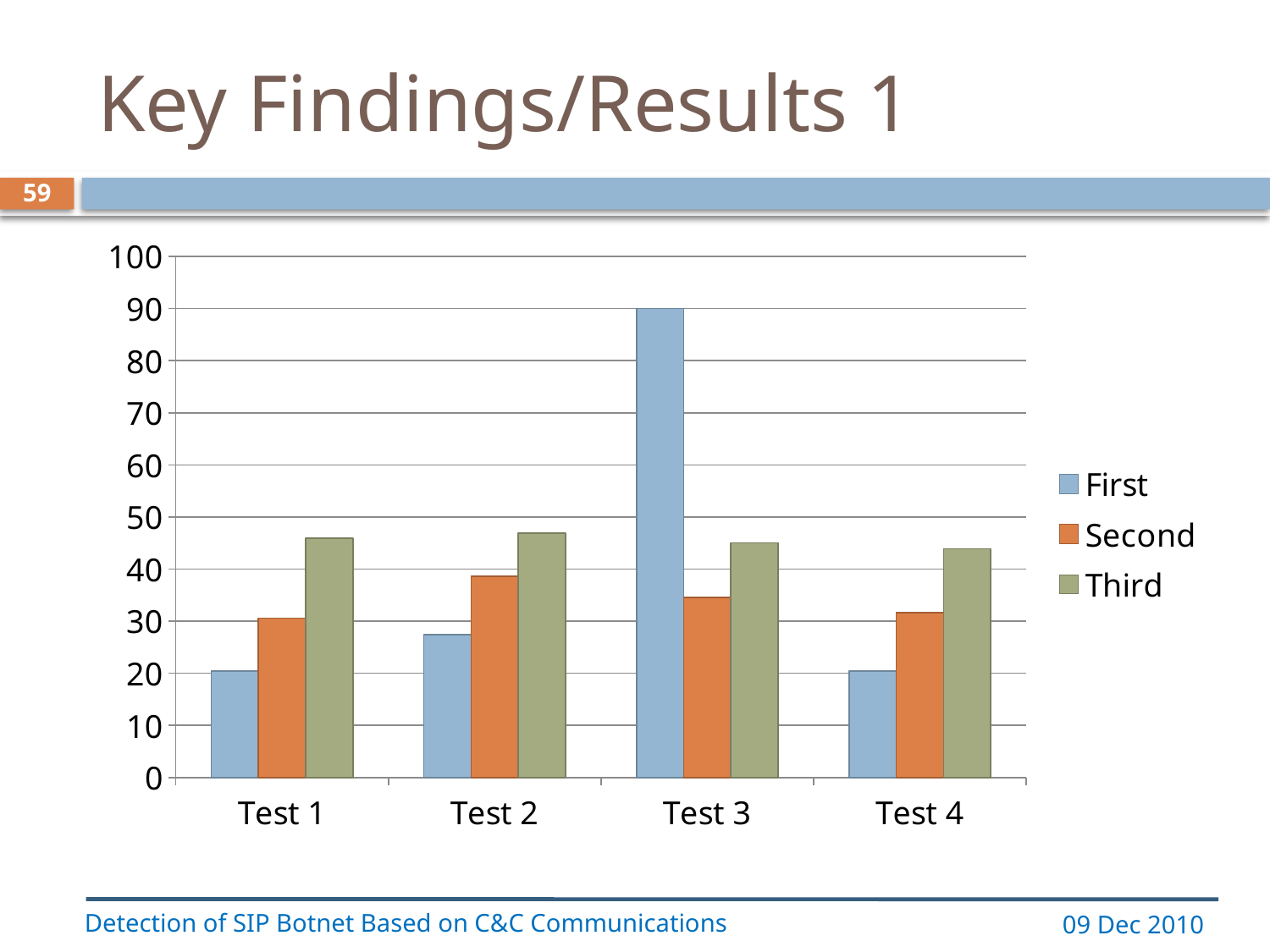
How many series does the legend list? 3 What type of chart is shown on the slide? bar chart For which test is the Second series highest? Test 2 For which test is the First series highest? Test 3 Is the value of the Third series for Test 1 greater or less than 40? greater For Test 1, which is larger: the First series or the Third series? Third Is the value of the First series for Test 2 greater or less than 30? less Which legend entry is shown in orange? Second How many test categories are shown on the x axis? 4 What is the value of the First series for Test 3? 90 For Test 3, which is larger: the First series or the Third series? First Is the value of the Second series for Test 3 greater or less than 40? less